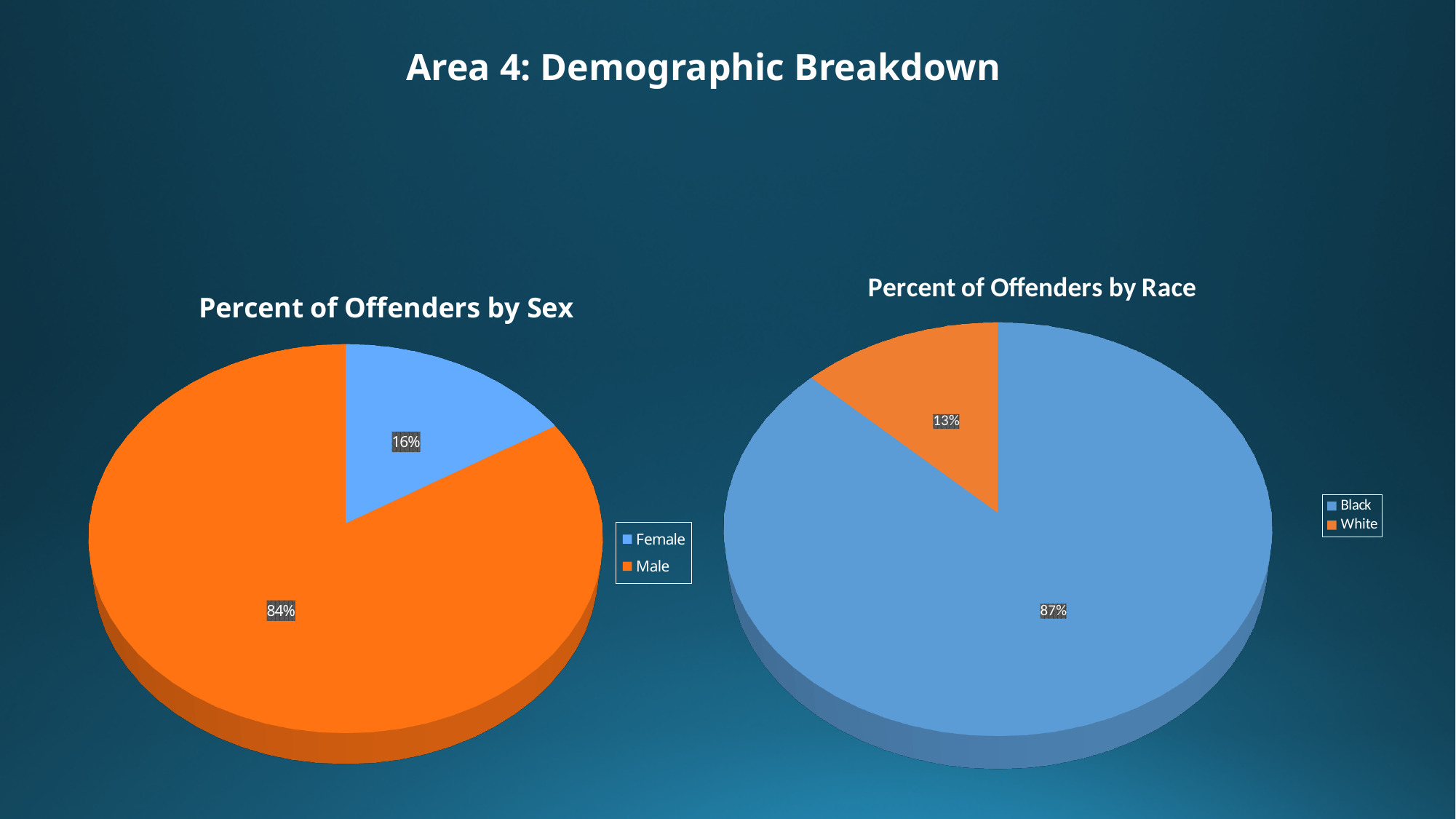
In the 'Percent of Offenders by Sex' chart, which category has the largest share? Male In the 'Percent of Offenders by Race' chart, which category has the smallest share? White In the 'Percent of Offenders by Sex' chart, what is the difference in percentage points between Male and Female? 68 In the 'Percent of Offenders by Race' chart, what is the difference in percentage points between Black and White? 74 How many categories does the legend of the 'Percent of Offenders by Sex' chart list? 2 Which is larger: the Female share in the 'Percent of Offenders by Sex' chart or the White share in the 'Percent of Offenders by Race' chart? Female What type of chart is the 'Percent of Offenders by Race' chart? Pie chart In the 'Percent of Offenders by Race' chart, what colour represents the Black category? Blue In the 'Percent of Offenders by Race' chart, what percentage of offenders are Black? 87% In the 'Percent of Offenders by Sex' chart, what percentage of offenders are Female? 16% In the 'Percent of Offenders by Race' chart, what percentage of offenders are White? 13% In the 'Percent of Offenders by Sex' chart, what percentage of offenders are Male? 84%